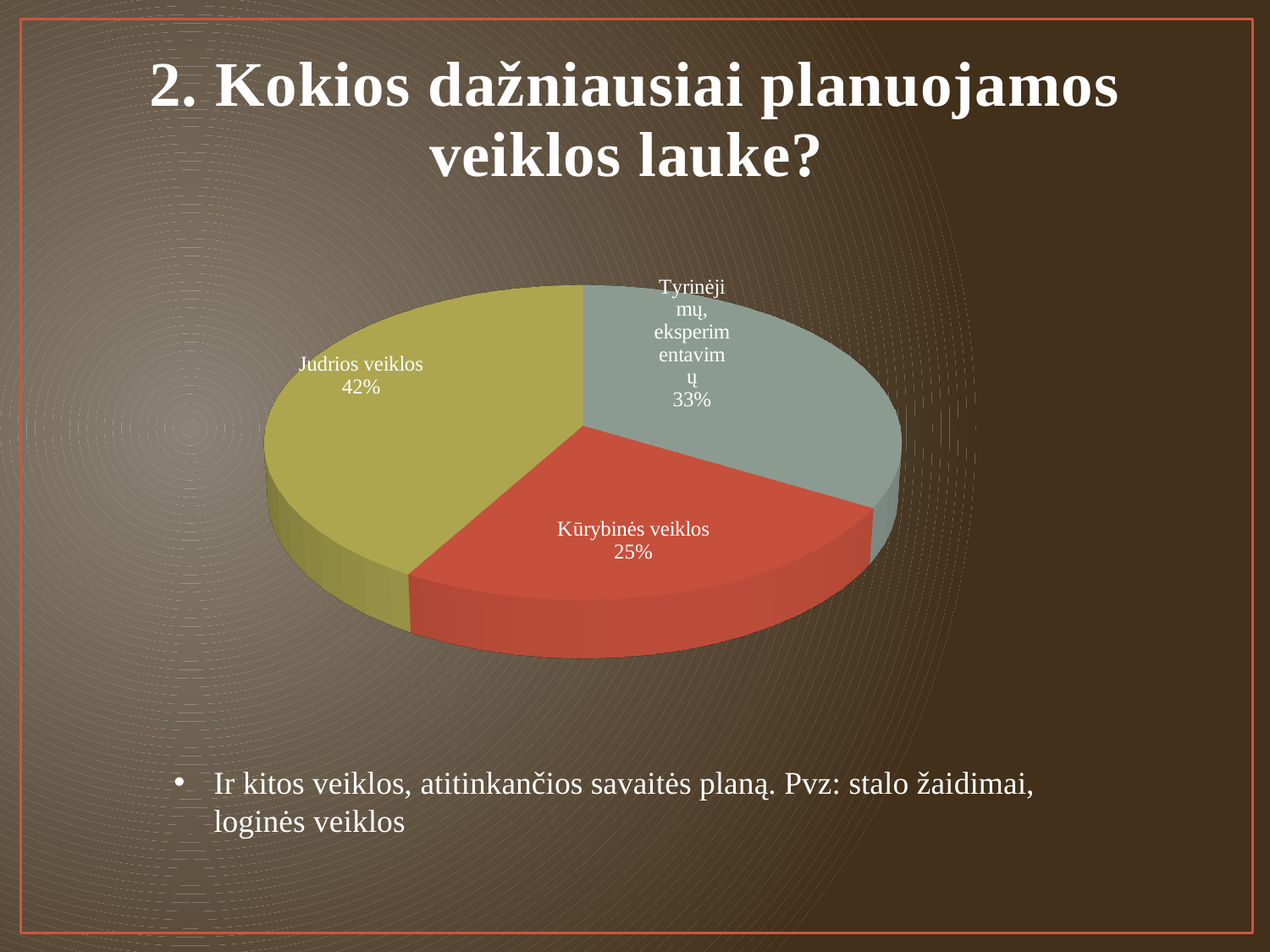
Which category has the largest slice of the pie? Judrios veiklos What is the difference in percentage points between Judrios veiklos and Kūrybinės veiklos? 17 What share of the pie is labelled for Judrios veiklos? 42% What share of the pie is labelled for Tyrinėjimų, eksperimentavimų? 33% Which category has the smallest slice of the pie? Kūrybinės veiklos What share of the pie is labelled for Kūrybinės veiklos? 25% Which is larger, the slice for Judrios veiklos or the slice for Tyrinėjimų, eksperimentavimų? Judrios veiklos What colour is the slice for Kūrybinės veiklos? red What colour is the slice for Judrios veiklos? olive green What is the difference in percentage points between Tyrinėjimų, eksperimentavimų and Kūrybinės veiklos? 8 How many slices does the pie chart have? 3 What kind of chart is shown on the slide? pie chart